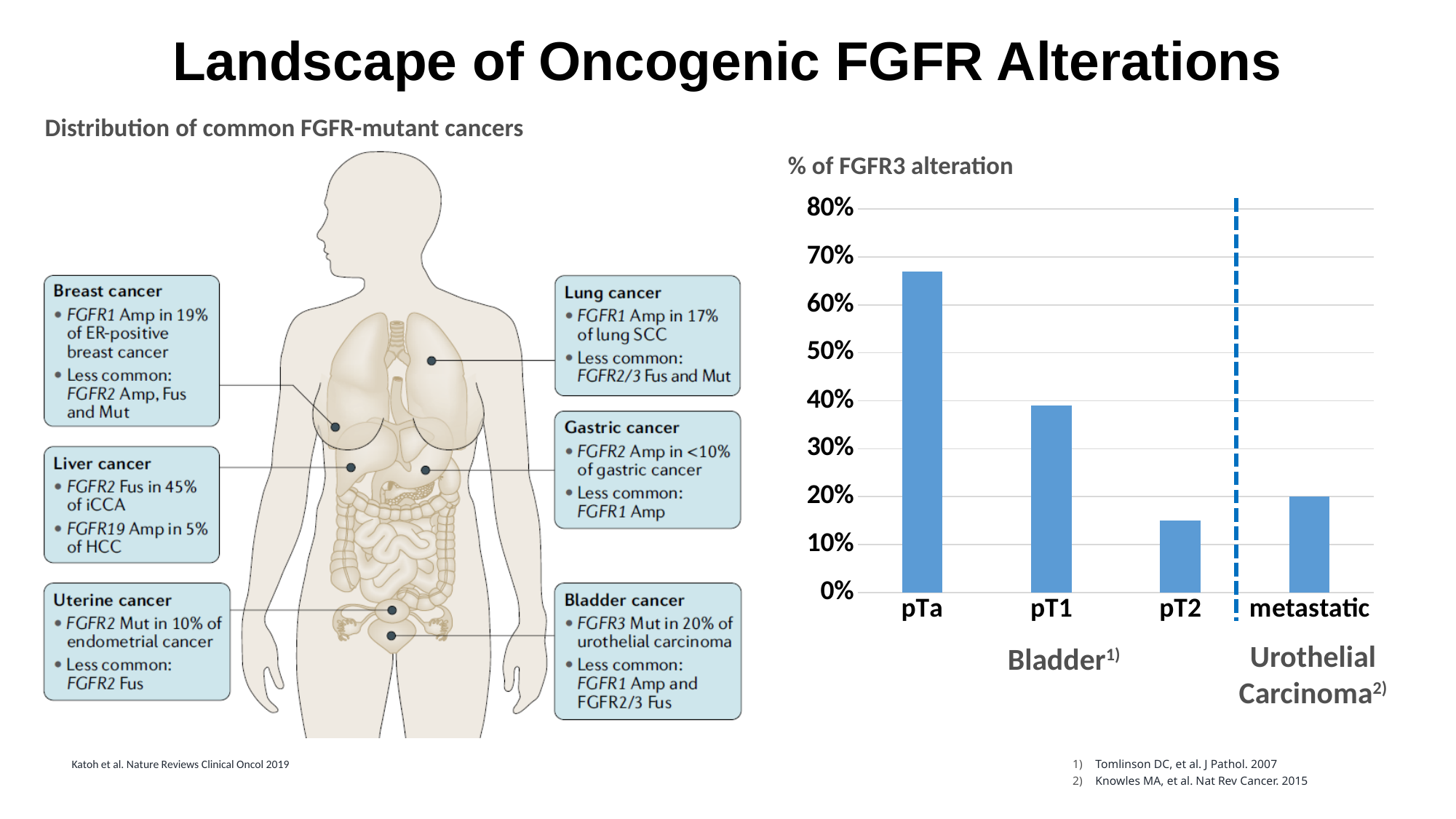
Do the values rise or fall across the bladder stages pTa, pT1 and pT2? fall What is the % of FGFR3 alteration for metastatic? 20% Which category has the highest % of FGFR3 alteration? pTa Which has a higher % of FGFR3 alteration, pTa or pT1? pTa What is the title of the bar chart on the right? % of FGFR3 alteration Which has a higher % of FGFR3 alteration, pT2 or metastatic? metastatic Is the % of FGFR3 alteration for pT2 greater or less than 20%? less How many categories are plotted on the x axis of the '% of FGFR3 alteration' chart? 4 Which category has the lowest % of FGFR3 alteration? pT2 Is the % of FGFR3 alteration for pTa greater or less than 60%? greater What kind of chart is shown on the right side of the slide? bar chart Is the % of FGFR3 alteration for pT1 greater or less than 30%? greater